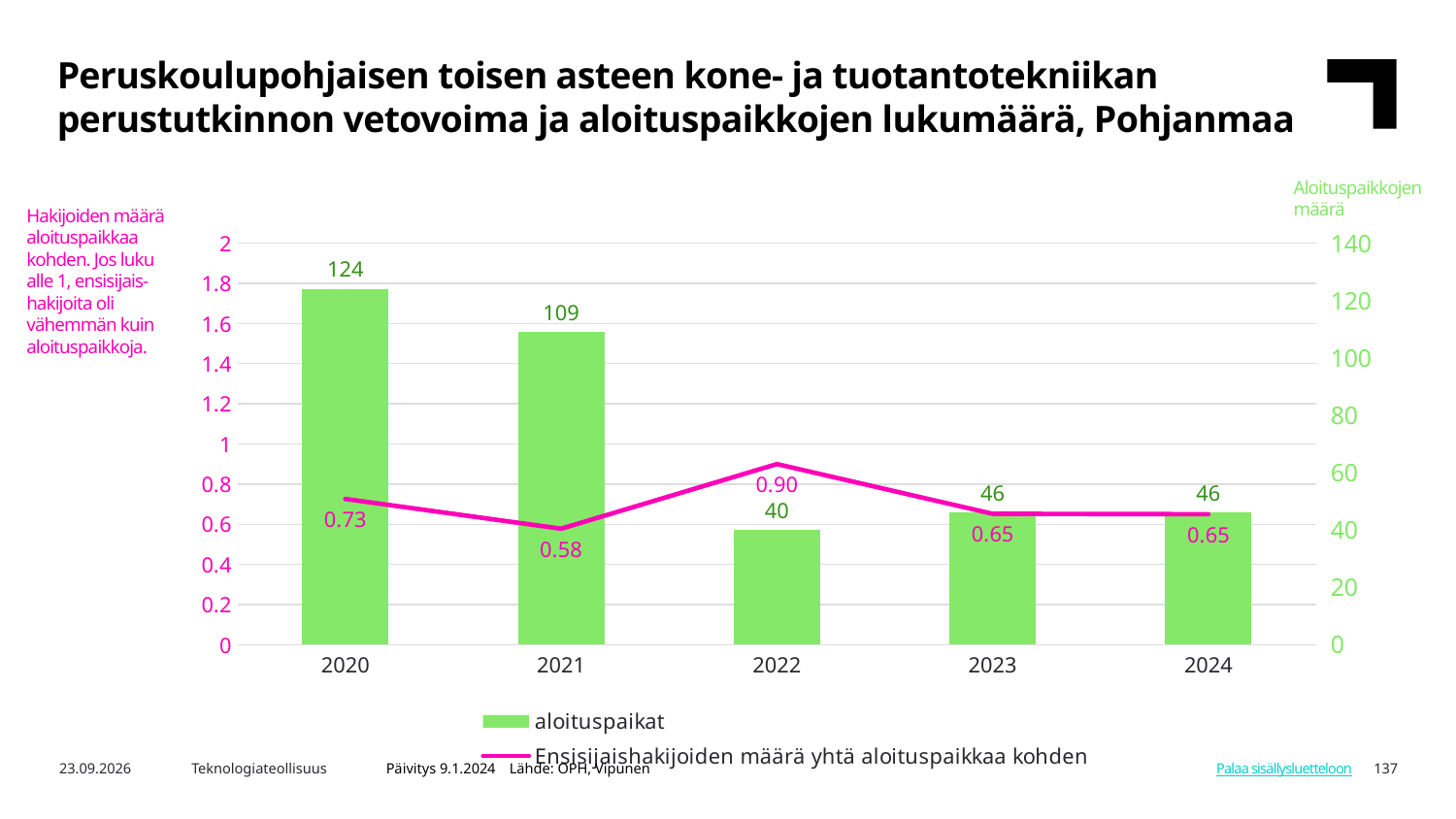
Which year has the lowest value of Ensisijaishakijoiden määrä yhtä aloituspaikkaa kohden? 2021 What is the value of aloituspaikat for 2020? 124 Which year has the highest value of aloituspaikat? 2020 Which year has the lowest value of aloituspaikat? 2022 Which is larger, the aloituspaikat value for 2021 or for 2023? 2021 What is the value of Ensisijaishakijoiden määrä yhtä aloituspaikkaa kohden for 2021? 0.58 What is the difference in aloituspaikat between 2020 and 2021? 15 What colour is the line for Ensisijaishakijoiden määrä yhtä aloituspaikkaa kohden? Pink What is the value of Ensisijaishakijoiden määrä yhtä aloituspaikkaa kohden for 2022? 0.90 How many years are shown on the x axis? 5 How many series does the legend list? 2 What is the value of aloituspaikat for 2022? 40